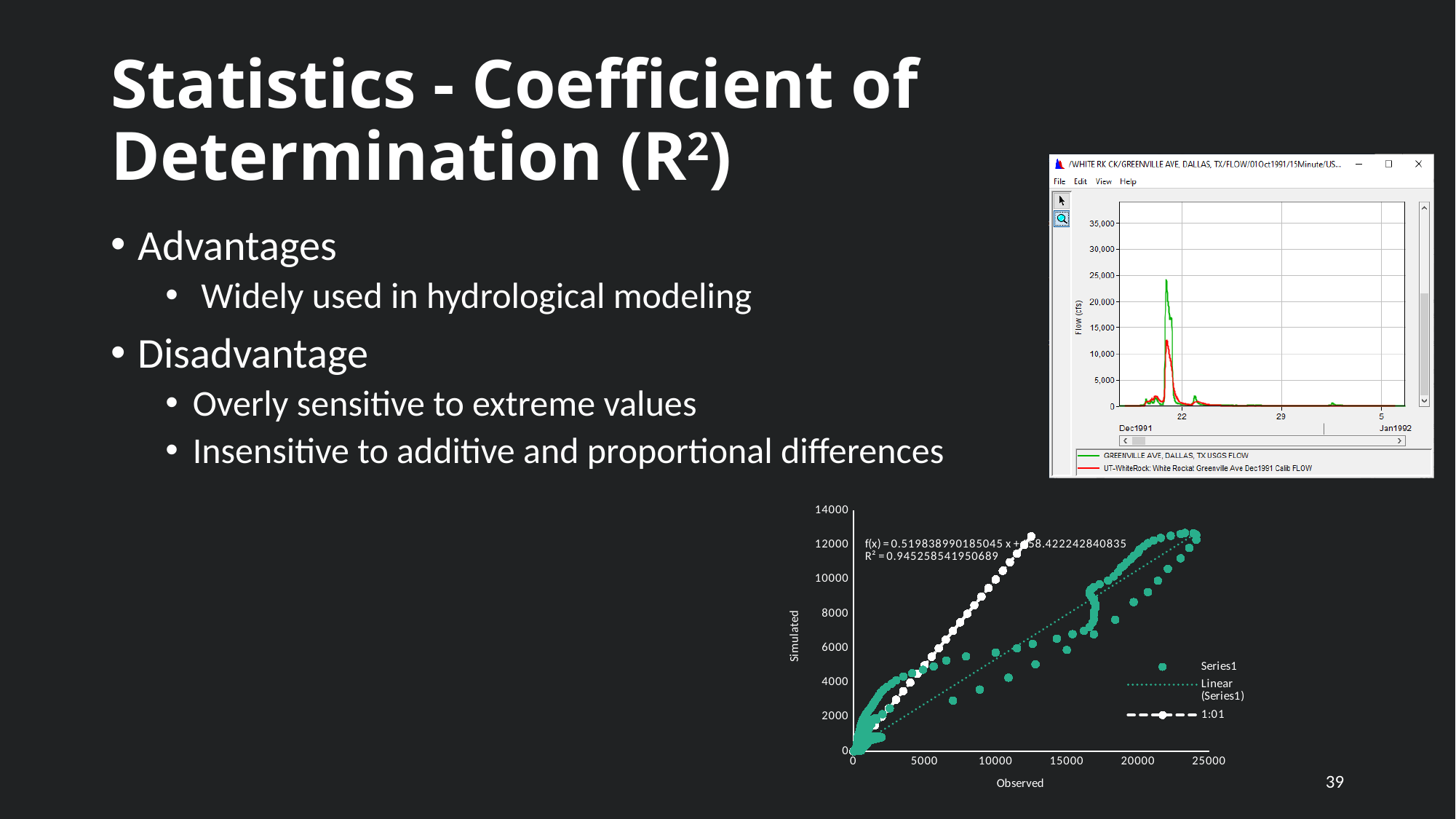
What kind of chart is the chart at the bottom right with axes Observed and Simulated? scatter chart How many entries does the legend of the scatter chart at the bottom right list? 3 In the scatter chart at the bottom right, what is the R² value printed on the chart? 0.945258541950689 What is the label of the vertical axis of the scatter chart at the bottom right? Simulated In the line chart at the top right, which series reaches the higher peak flow: the green GREENVILLE AVE, DALLAS, TX USGS FLOW series or the red UT-WhiteRock Calib FLOW series? GREENVILLE AVE, DALLAS, TX USGS FLOW What kind of chart is shown in the window screenshot at the top right of the slide? line chart What is the label of the horizontal axis of the scatter chart at the bottom right? Observed In the scatter chart at the bottom right, what is the slope coefficient of x in the printed trendline equation f(x)? 0.519838990185045 In the line chart at the top right, is the peak of the green GREENVILLE AVE, DALLAS, TX USGS FLOW series greater or less than 20,000? greater How many series does the legend of the line chart at the top right list? 2 In the scatter chart at the bottom right, is the highest Series1 simulated value greater or less than 10000? greater In the scatter chart at the bottom right, do the Series1 simulated values generally rise or fall as the observed values increase? rise